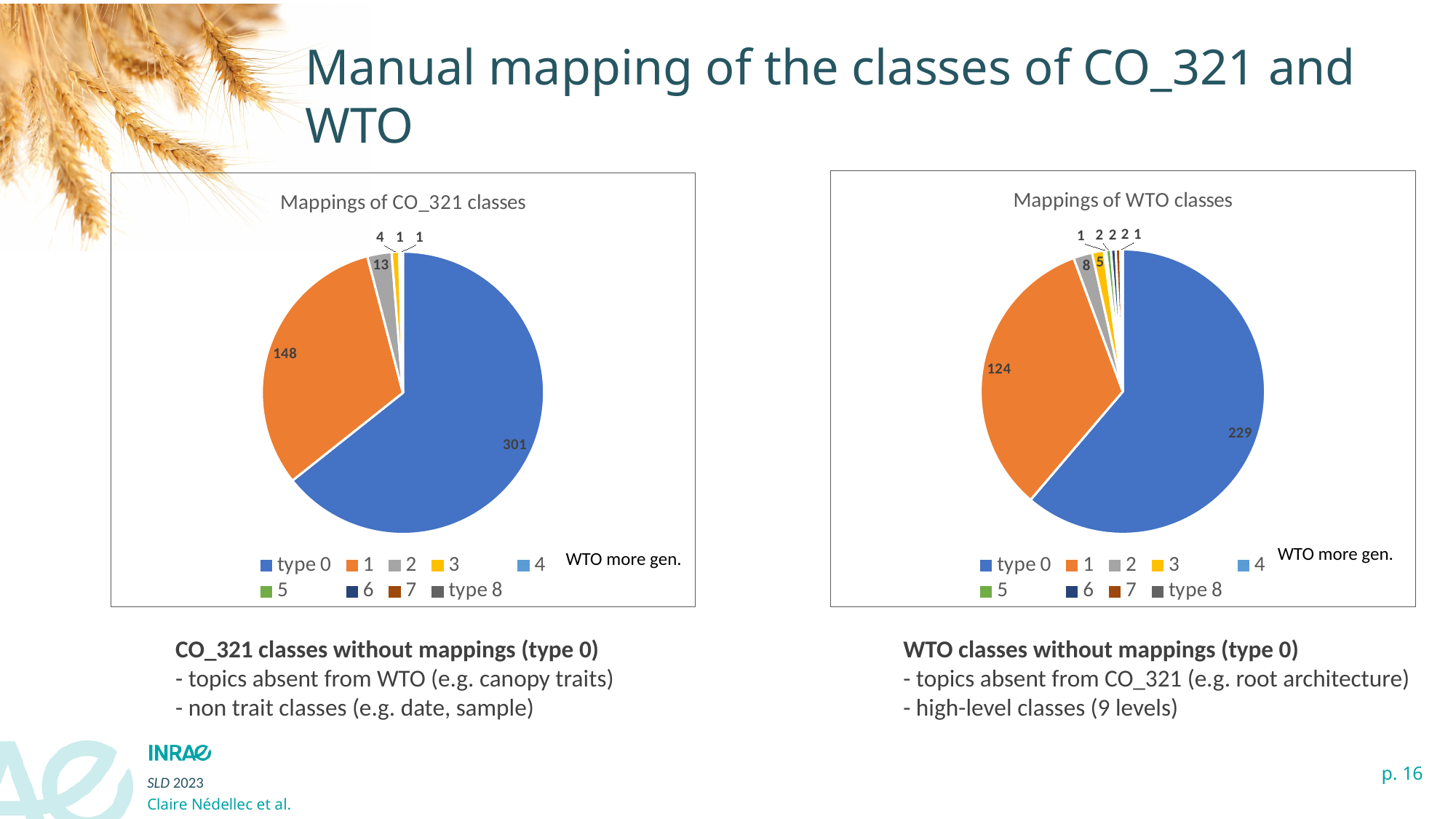
In the 'Mappings of WTO classes' chart, what is the difference between the values for type 0 and category 1? 105 How many entries does the legend of the 'Mappings of CO_321 classes' chart list? 9 In the 'Mappings of CO_321 classes' chart, which category has the largest slice? type 0 In the 'Mappings of CO_321 classes' chart, what is the value for category 2? 13 What kind of chart is the 'Mappings of WTO classes' chart? pie chart In the 'Mappings of WTO classes' chart, what is the value for type 0? 229 In the 'Mappings of WTO classes' chart, what is the value for category 1? 124 In the 'Mappings of CO_321 classes' chart, what is the difference between the values for type 0 and category 1? 153 In the 'Mappings of CO_321 classes' chart, what is the value for type 0? 301 In the 'Mappings of CO_321 classes' chart, what is the value for category 1? 148 In the 'Mappings of WTO classes' chart, what is the value for category 2? 8 In the 'Mappings of WTO classes' chart, which category has the largest slice? type 0